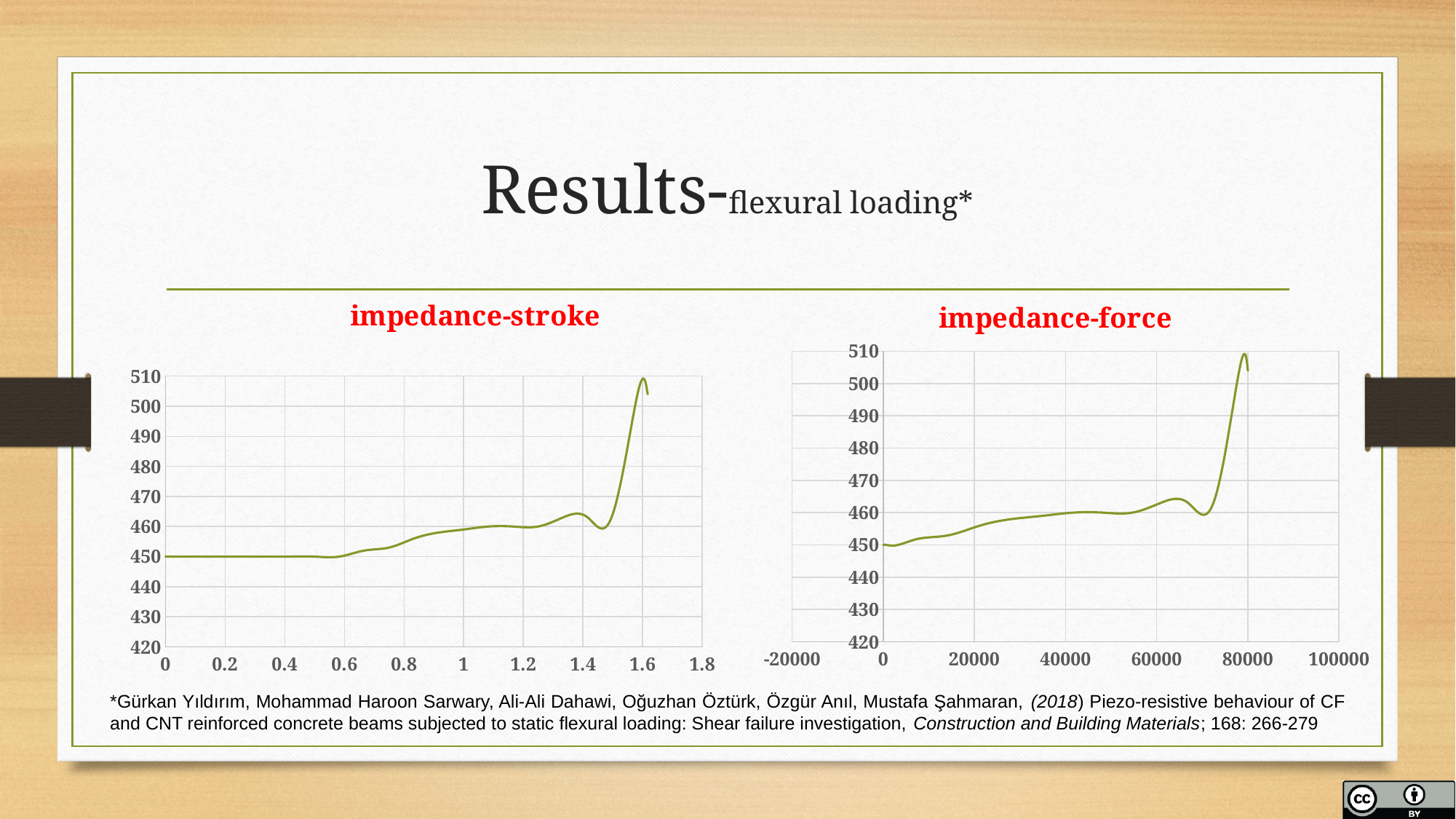
What is the title of the chart on the right of the slide? impedance-force In the impedance-stroke chart, is the value at x = 1.0 greater or less than 470? less What is the title of the chart on the left of the slide? impedance-stroke In the impedance-force chart, is the value at x = 40000 greater or less than 470? less In the impedance-force chart, is the value at x = 0 greater or less than 460? less In the impedance-stroke chart, do the values generally rise or fall as the x axis increases from 0 to 1.6? rise In the impedance-force chart, do the values generally rise or fall as the x axis increases from 0 to 80000? rise What kind of chart is the impedance-stroke chart on the left? line chart What kind of chart is the impedance-force chart on the right? line chart